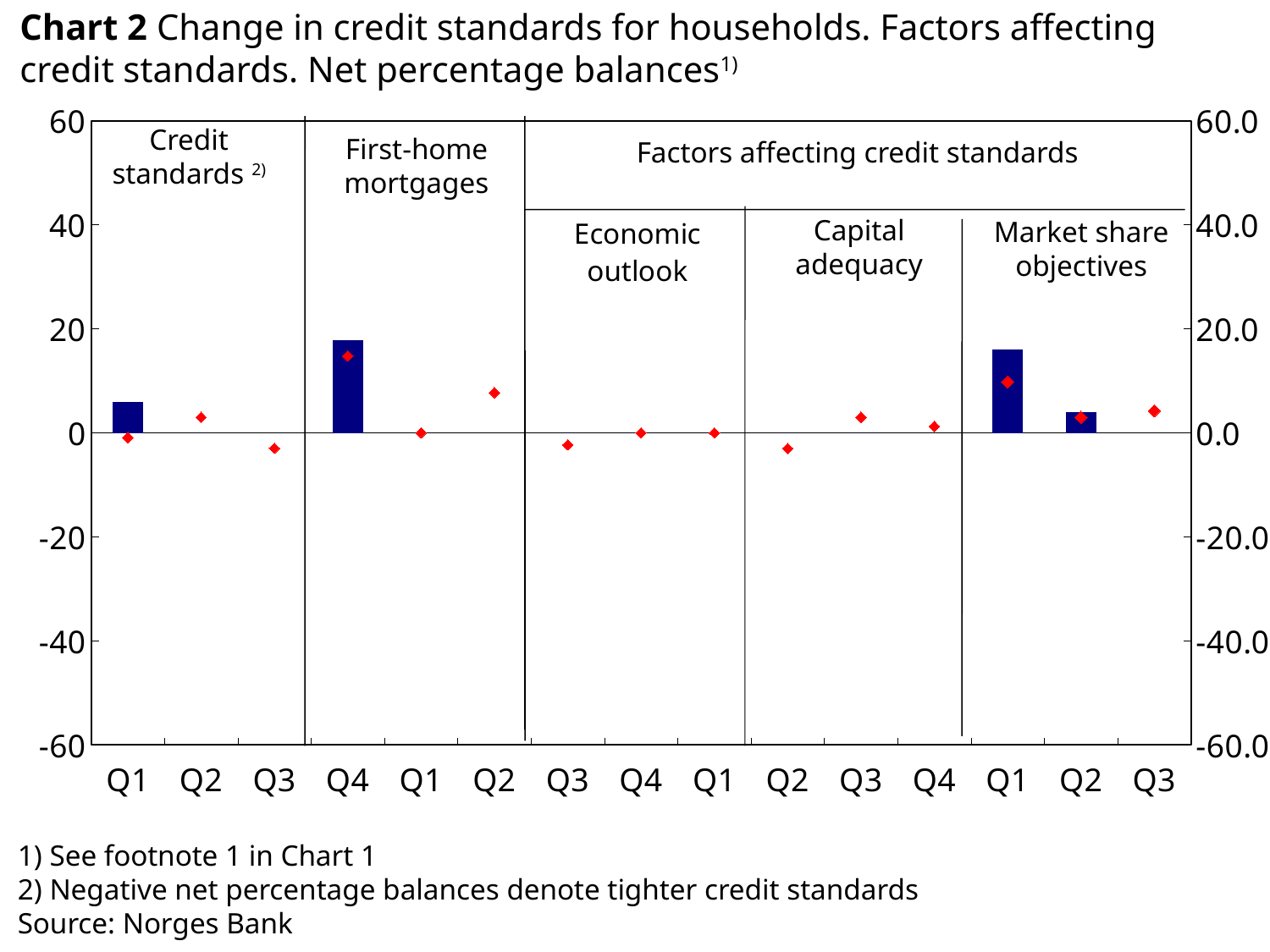
How many blue bars are plotted in Chart 2? 4 What is the source given for Chart 2? Norges Bank Is the value of the First-home mortgages Q4 bar greater or less than 0? greater How many quarter labels are shown along the x axis of Chart 2? 15 Is the value of the Market share objectives Q1 bar greater or less than 0? greater Which bar is taller: the Credit standards Q1 bar or the First-home mortgages Q4 bar? First-home mortgages Q4 Is the value of the First-home mortgages Q4 bar greater or less than 20? less How many factors are listed under the heading 'Factors affecting credit standards' in Chart 2? 3 Within the Market share objectives panel, which bar is taller, Q1 or Q2? Q1 What kind of chart is Chart 2? combination bar and line chart (blue bars with red diamond markers)